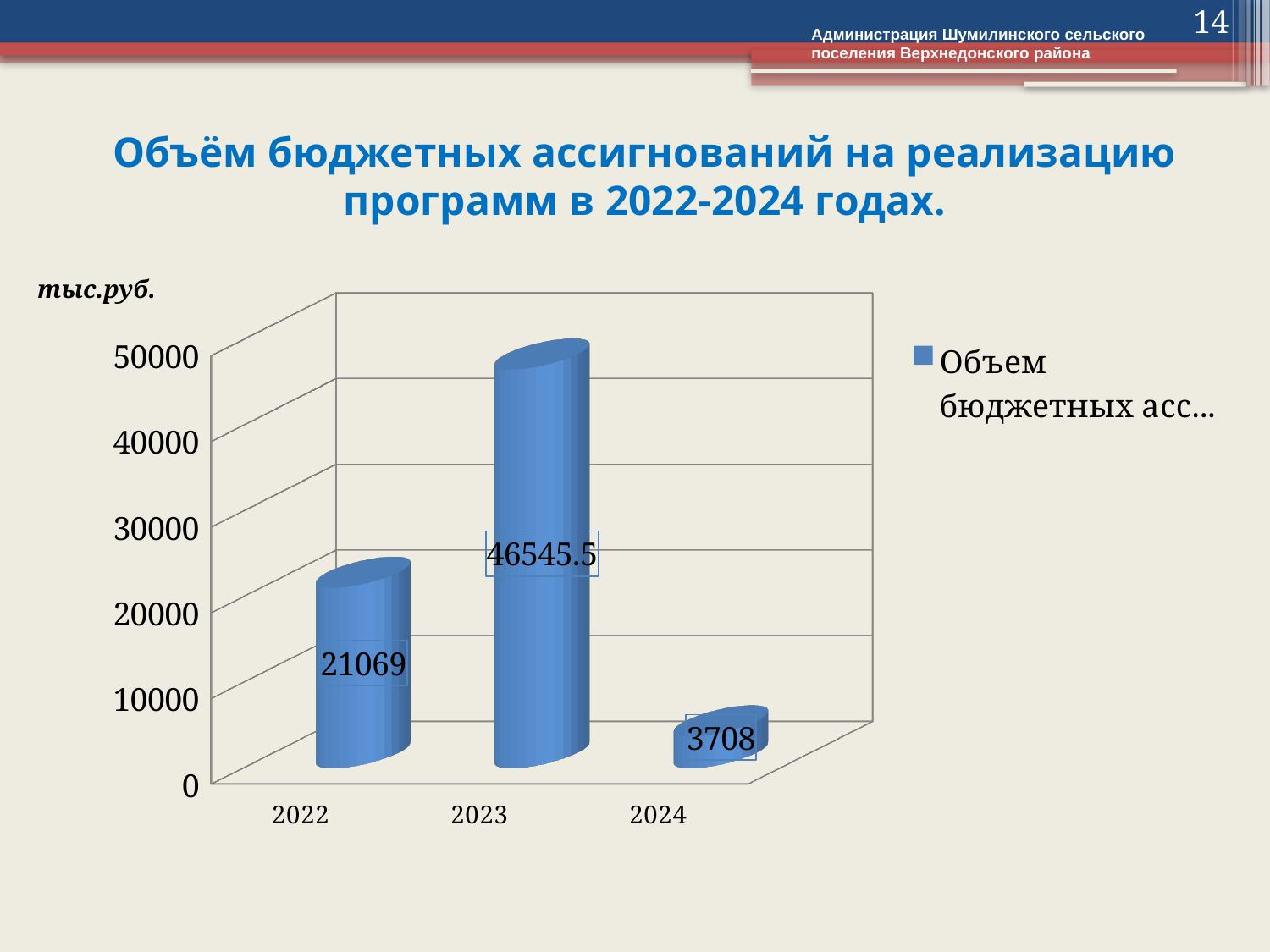
What is the difference between the values for 2023 and 2022? 25476.5 Which is larger, the value for 2022 or the value for 2024? 2022 What is the value for 2024? 3708 Which year has the lowest value? 2024 What kind of chart is shown on the slide? bar chart What is the value for 2022? 21069 What is the value for 2023? 46545.5 How many years are shown on the x axis? 3 Is the value for 2023 greater or less than 40000? greater Which year has the highest value? 2023 What is the difference between the values for 2022 and 2024? 17361 What unit is indicated above the vertical axis of the chart? тыс.руб.